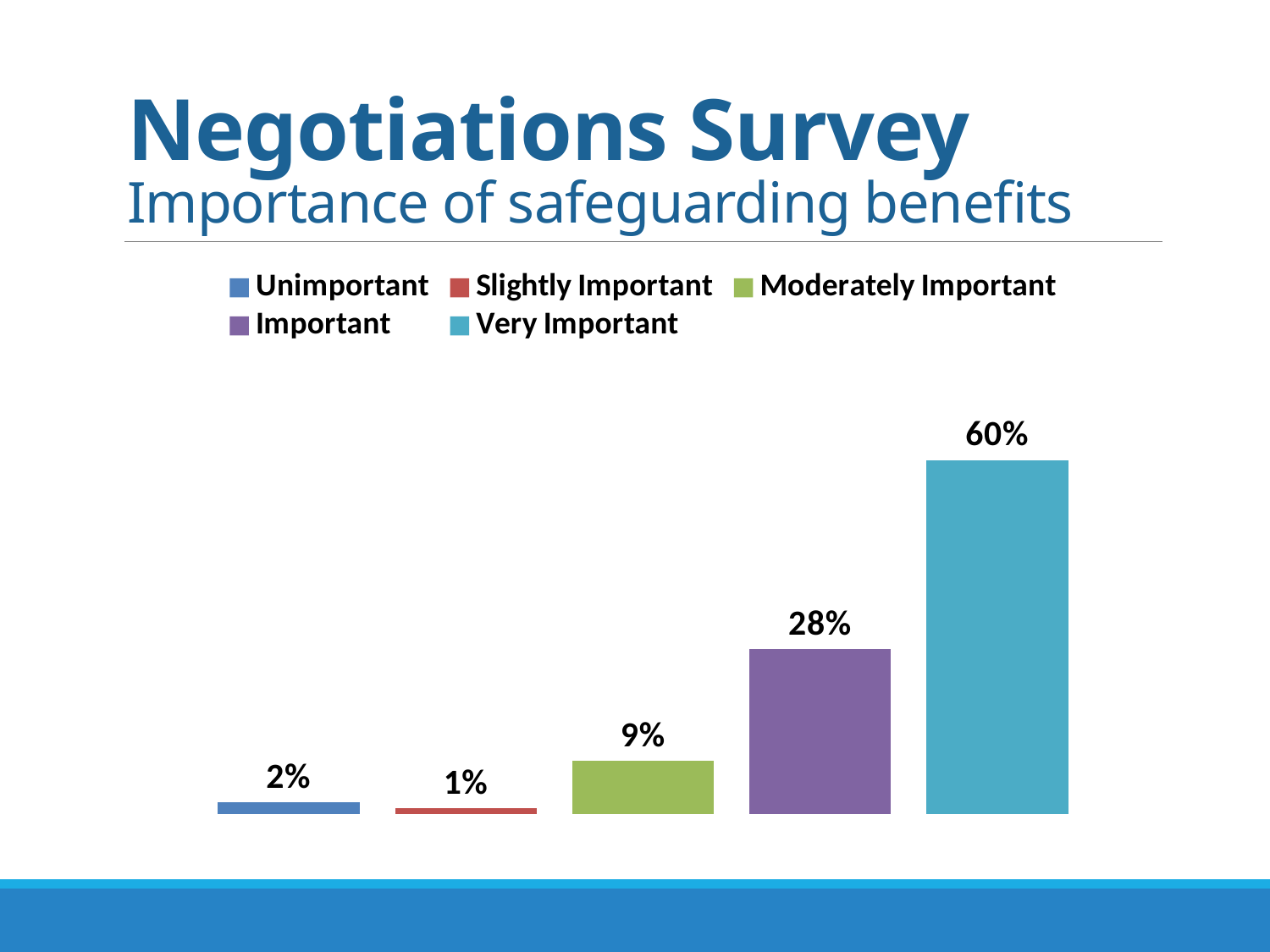
Which rating category has the highest percentage? Very Important What is the subtitle of the chart on the slide? Importance of safeguarding benefits How many series does the legend list? 5 What is the difference between the Very Important and Important percentages? 32% Which rating category has the lowest percentage? Slightly Important What kind of chart is shown on the slide? Bar chart Which is larger, the percentage for Moderately Important or for Unimportant? Moderately Important What percentage of respondents rated safeguarding benefits as Moderately Important? 9% What percentage of respondents rated safeguarding benefits as Unimportant? 2% What percentage of respondents rated safeguarding benefits as Slightly Important? 1% What percentage of respondents rated safeguarding benefits as Very Important? 60% What percentage of respondents rated safeguarding benefits as Important? 28%